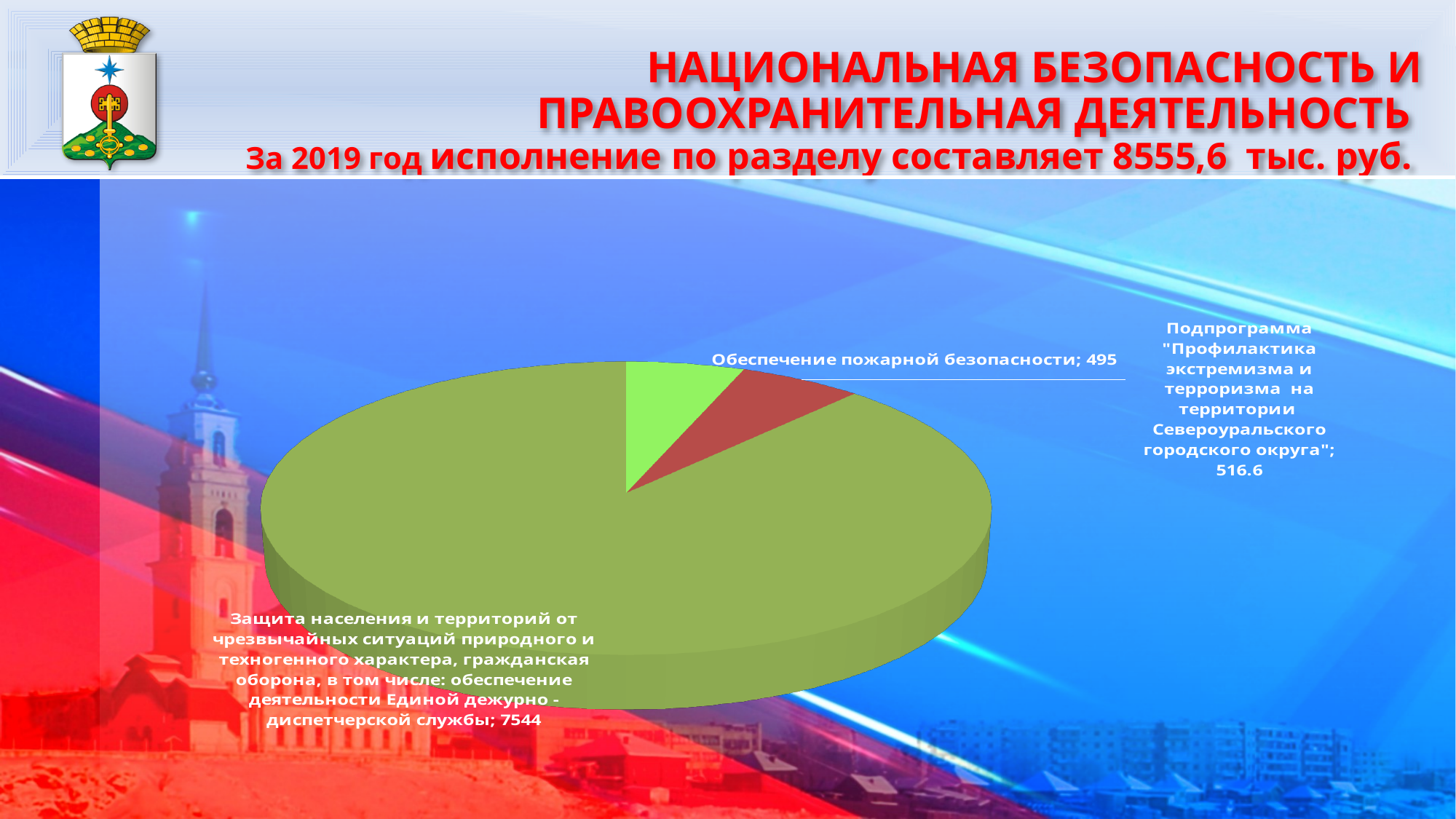
What is the difference between the value for the subprogram "Профилактика экстремизма и терроризма" and the value for "Обеспечение пожарной безопасности"? 21.6 How many slices does the pie chart have? 3 What is the value for the subprogram "Профилактика экстремизма и терроризма на территории Североуральского городского округа"? 516.6 What is the value for "Обеспечение пожарной безопасности"? 495 Which category has the smallest slice of the pie? Обеспечение пожарной безопасности According to the slide title, what was the execution for the section in 2019? 8555,6 тыс. руб. What type of chart is shown on the slide? Pie chart What is the total of all three slices in the pie chart? 8555.6 What is the value for "Защита населения и территорий от чрезвычайных ситуаций природного и техногенного характера, гражданская оборона, в том числе: обеспечение деятельности Единой дежурно-диспетчерской службы"? 7544 Which category has the largest slice of the pie? Защита населения и территорий от чрезвычайных ситуаций природного и техногенного характера, гражданская оборона, в том числе: обеспечение деятельности Единой дежурно-диспетчерской службы What is the difference between the value for "Защита населения и территорий от чрезвычайных ситуаций..." and the value for "Обеспечение пожарной безопасности"? 7049 Which is larger: the value for "Обеспечение пожарной безопасности" or the value for the subprogram "Профилактика экстремизма и терроризма"? Подпрограмма "Профилактика экстремизма и терроризма"